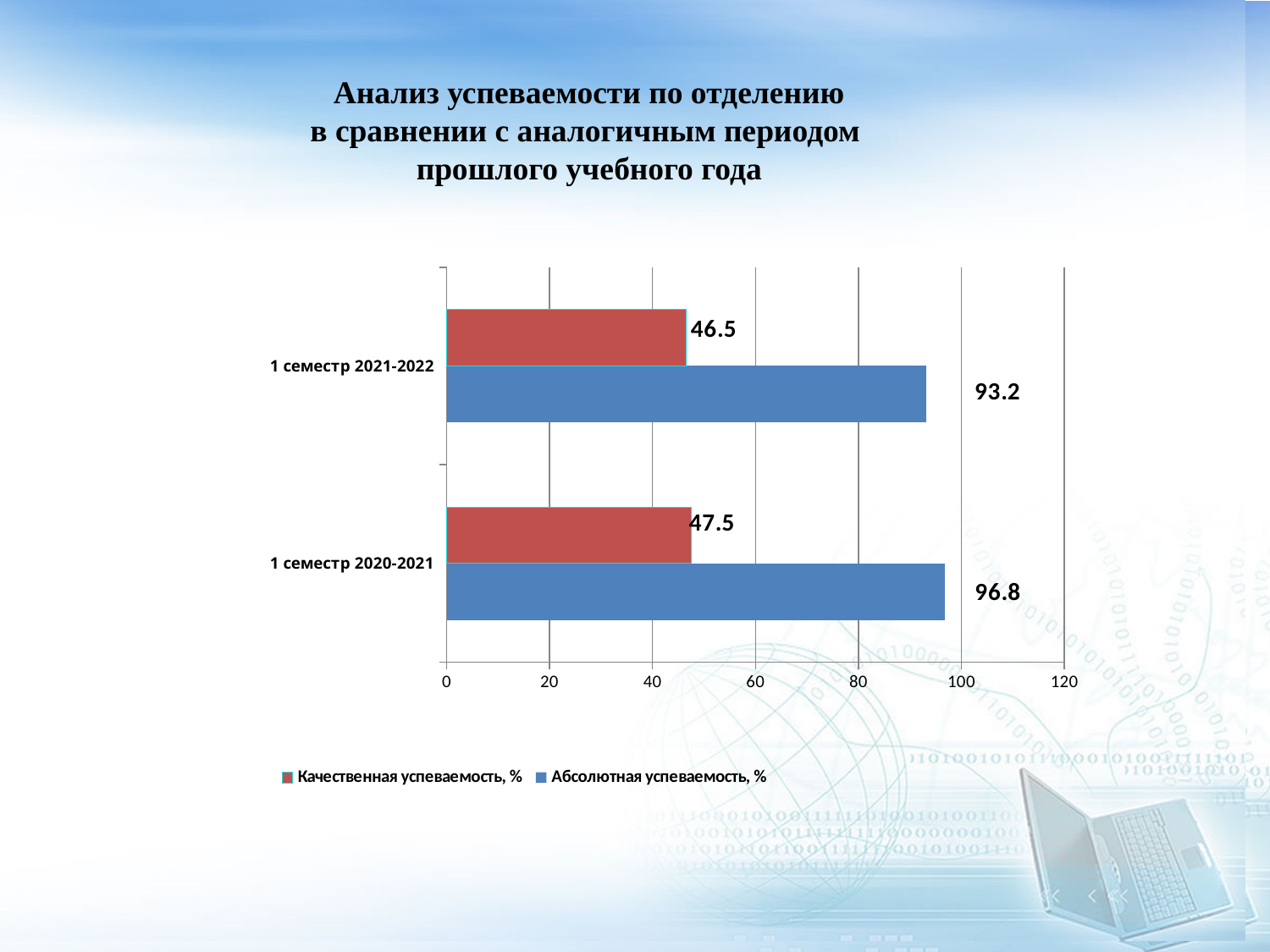
What is the difference between Качественная успеваемость, % for 1 семестр 2020-2021 and 1 семестр 2021-2022? 1 How many categories are shown on the chart? 2 What is the difference between Абсолютная успеваемость, % for 1 семестр 2020-2021 and 1 семестр 2021-2022? 3.6 Which is larger: Абсолютная успеваемость, % for 1 семестр 2021-2022 or Качественная успеваемость, % for 1 семестр 2021-2022? Абсолютная успеваемость, % What kind of chart is shown on the slide? bar chart What is the value of Абсолютная успеваемость, % for 1 семестр 2020-2021? 96.8 What is the value of Абсолютная успеваемость, % for 1 семестр 2021-2022? 93.2 What is the value of Качественная успеваемость, % for 1 семестр 2020-2021? 47.5 Is the value of Абсолютная успеваемость, % for 1 семестр 2020-2021 greater or less than 100? less Which category has the higher value for Абсолютная успеваемость, %? 1 семестр 2020-2021 How many series does the legend list? 2 What is the value of Качественная успеваемость, % for 1 семестр 2021-2022? 46.5